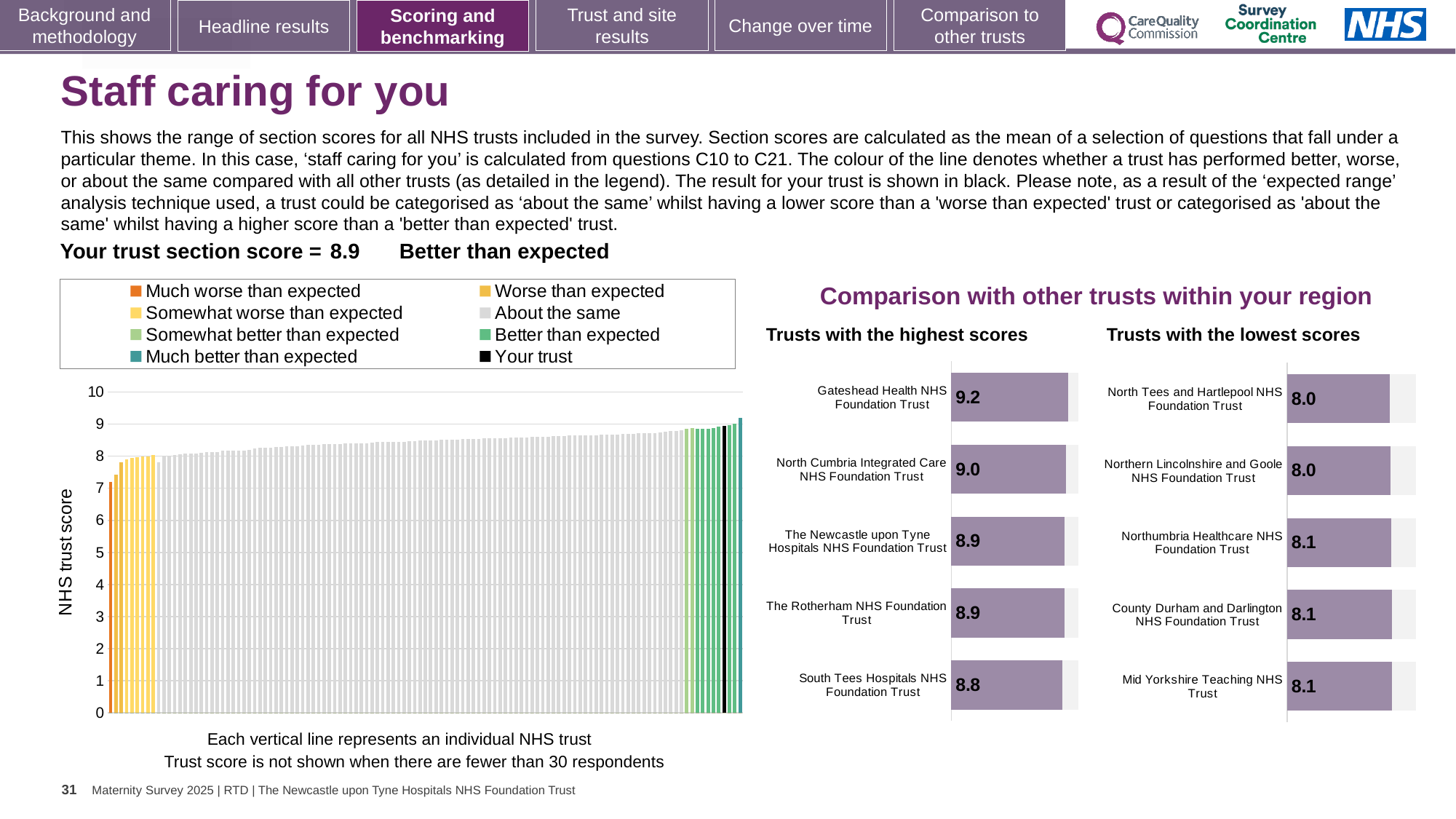
In the 'Trusts with the highest scores' chart, which trust has the lowest score? South Tees Hospitals NHS Foundation Trust How many entries does the legend of the main chart on the left list? 8 In the 'Trusts with the lowest scores' chart, what is the difference between the scores of Mid Yorkshire Teaching NHS Trust and North Tees and Hartlepool NHS Foundation Trust? 0.1 In the main chart on the left showing all NHS trusts, is the value for the black bar (your trust) greater or less than 8? greater In the 'Trusts with the lowest scores' chart, what is the score for Northumbria Healthcare NHS Foundation Trust? 8.1 In the 'Trusts with the highest scores' chart, what is the score for South Tees Hospitals NHS Foundation Trust? 8.8 How many trusts are shown in the 'Trusts with the lowest scores' chart? 5 In the 'Trusts with the highest scores' chart, what is the score for Gateshead Health NHS Foundation Trust? 9.2 In the main chart on the left showing all NHS trusts, do the values rise or fall from left to right? rise In the 'Trusts with the highest scores' chart, what is the difference between the scores of Gateshead Health NHS Foundation Trust and North Cumbria Integrated Care NHS Foundation Trust? 0.2 Which is larger: the score for Gateshead Health NHS Foundation Trust in the highest scores chart or the score for North Tees and Hartlepool NHS Foundation Trust in the lowest scores chart? Gateshead Health NHS Foundation Trust In the 'Trusts with the highest scores' chart, which trust has the highest score? Gateshead Health NHS Foundation Trust